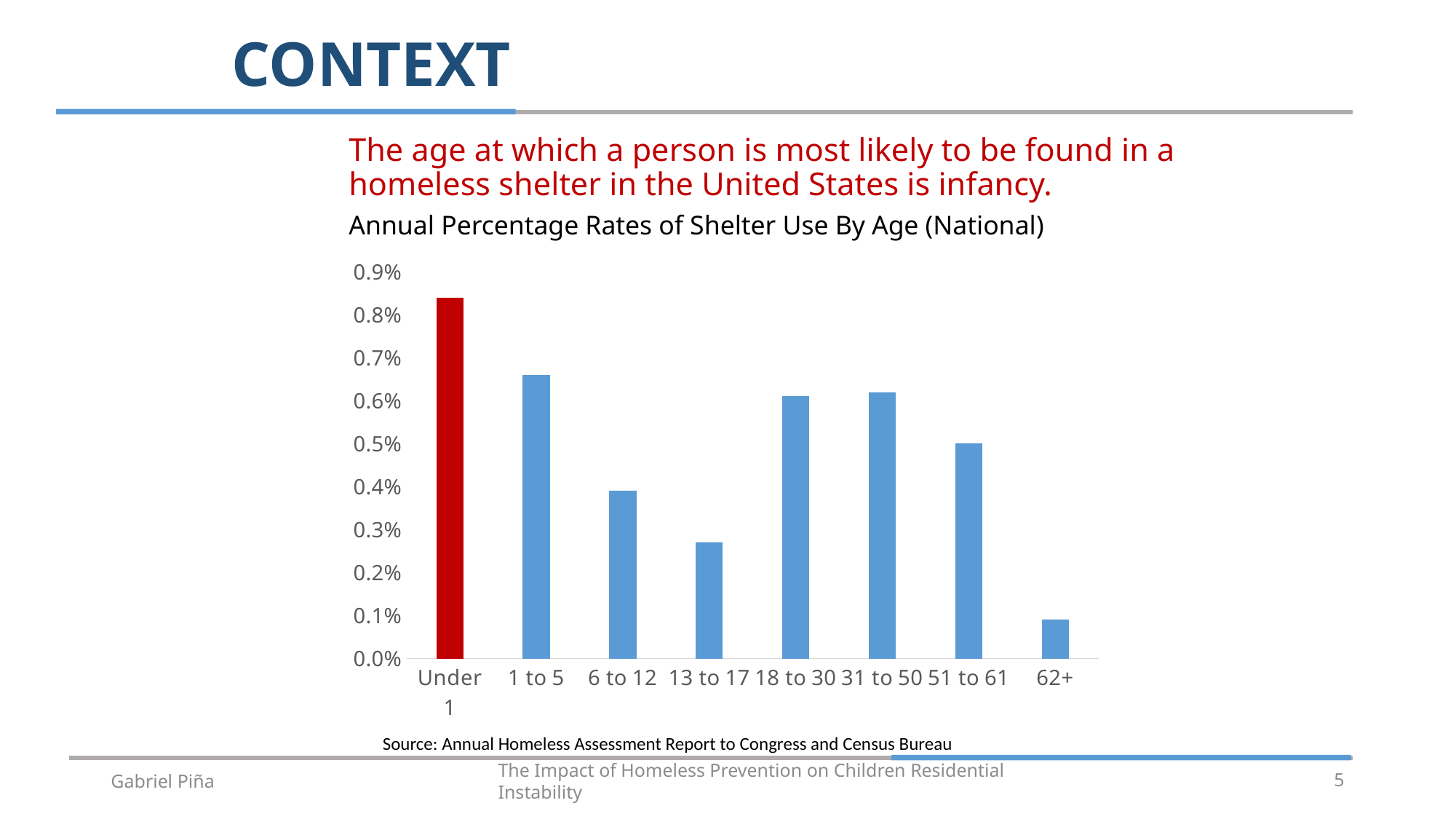
Which age category has the lowest annual percentage rate of shelter use? 62+ What is the title of the chart? Annual Percentage Rates of Shelter Use By Age (National) Which bar in the chart is coloured red rather than blue? Under 1 Is the value for 6 to 12 greater or less than 0.3%? greater What type of chart is shown on the slide? bar chart Which age category has the highest annual percentage rate of shelter use? Under 1 Is the value for 62+ greater or less than 0.2%? less Is the value for Under 1 greater or less than 0.8%? greater Which has a higher shelter use rate, 1 to 5 or 6 to 12? 1 to 5 Which has a higher shelter use rate, 51 to 61 or 62+? 51 to 61 How many age categories are shown on the x axis of the chart? 8